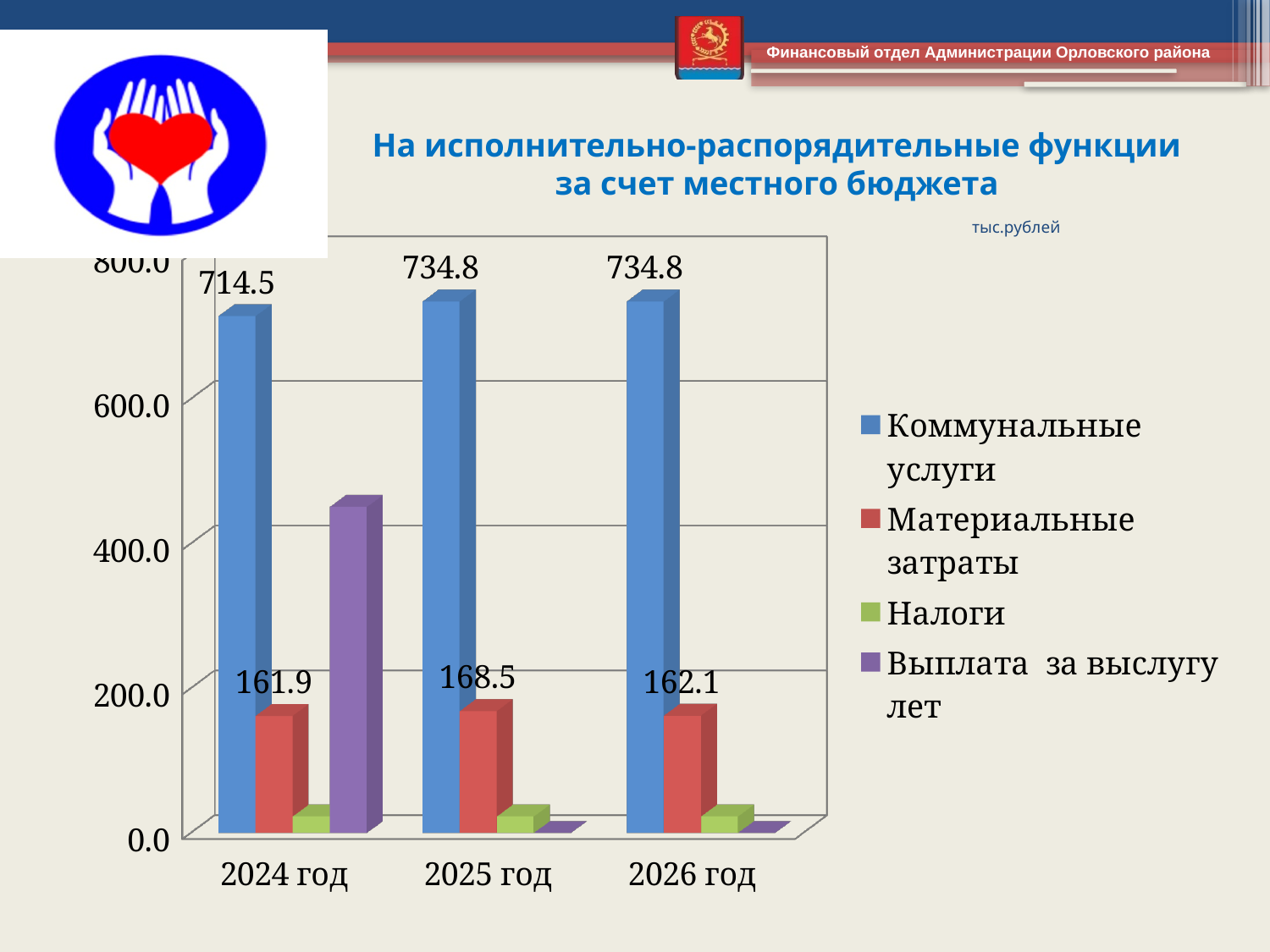
What is the value for Материальные затраты in 2025 год? 168.5 In which year is Материальные затраты the highest? 2025 год What is the value for Коммунальные услуги in 2024 год? 714.5 Which is larger: Материальные затраты in 2024 год or in 2026 год? 2026 год What is the difference between Коммунальные услуги in 2025 год and in 2024 год? 20.3 What kind of chart is shown on the slide? Bar chart What unit is stated above the chart? тыс.рублей In which year is Коммунальные услуги the lowest? 2024 год What is the value for Коммунальные услуги in 2026 год? 734.8 How many series does the legend list? 4 What is the value for Материальные затраты in 2026 год? 162.1 Is the value for Выплата за выслугу лет in 2024 год greater or less than 400? greater